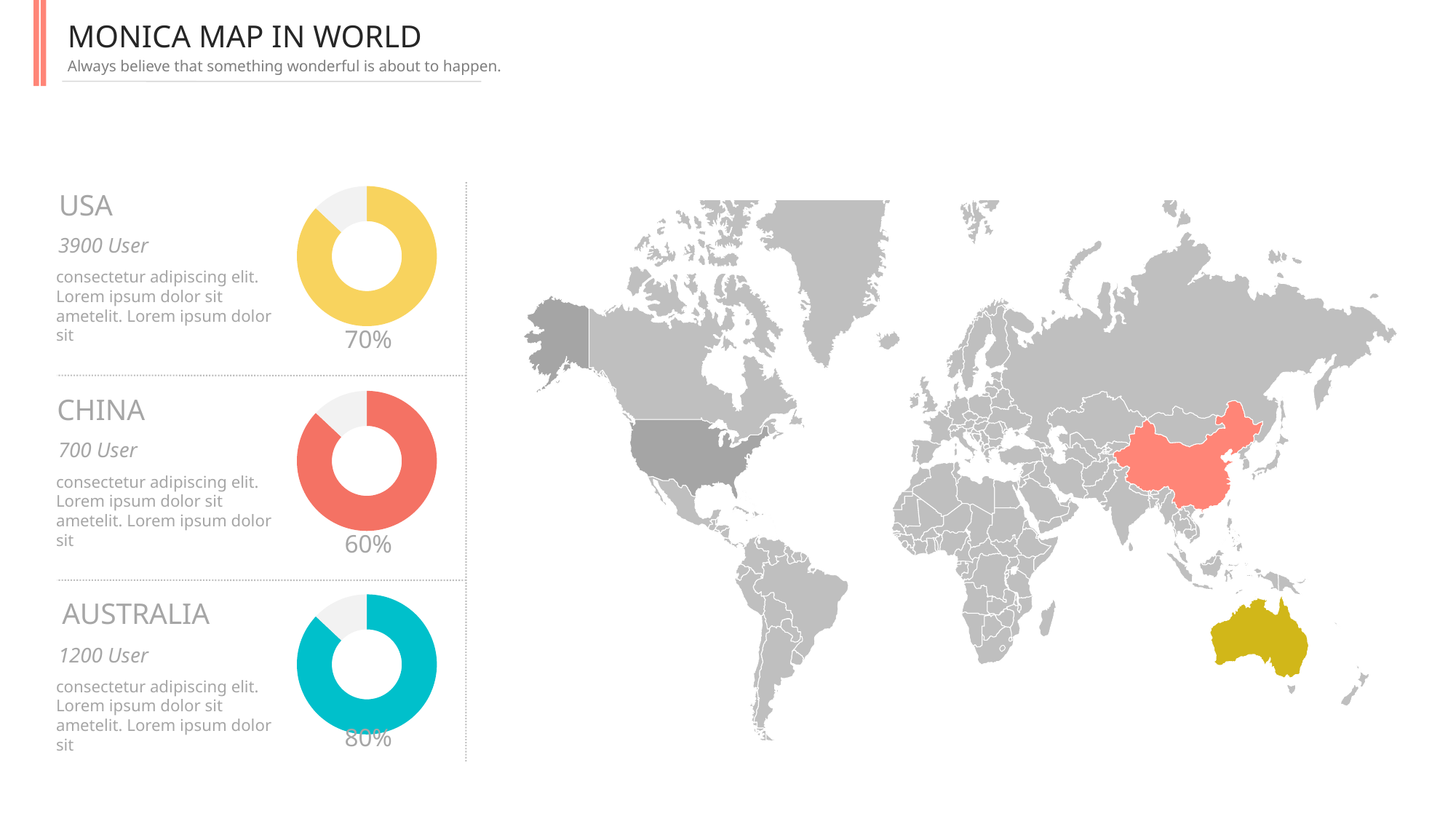
What percentage is shown on the USA donut chart? 70% Which country's donut chart shows the lowest percentage? CHINA Which is larger, the USA percentage or the CHINA percentage? USA What percentage is shown on the AUSTRALIA donut chart? 80% What colour is the filled portion of the AUSTRALIA donut chart? Teal What is the difference between the AUSTRALIA percentage and the CHINA percentage? 20% What colour is the filled portion of the CHINA donut chart? Red How many donut charts are on the slide? 3 What kind of chart is used to show each country's percentage? Donut chart Which country's donut chart shows the highest percentage? AUSTRALIA What percentage is shown on the CHINA donut chart? 60% What is the difference between the USA percentage and the CHINA percentage? 10%